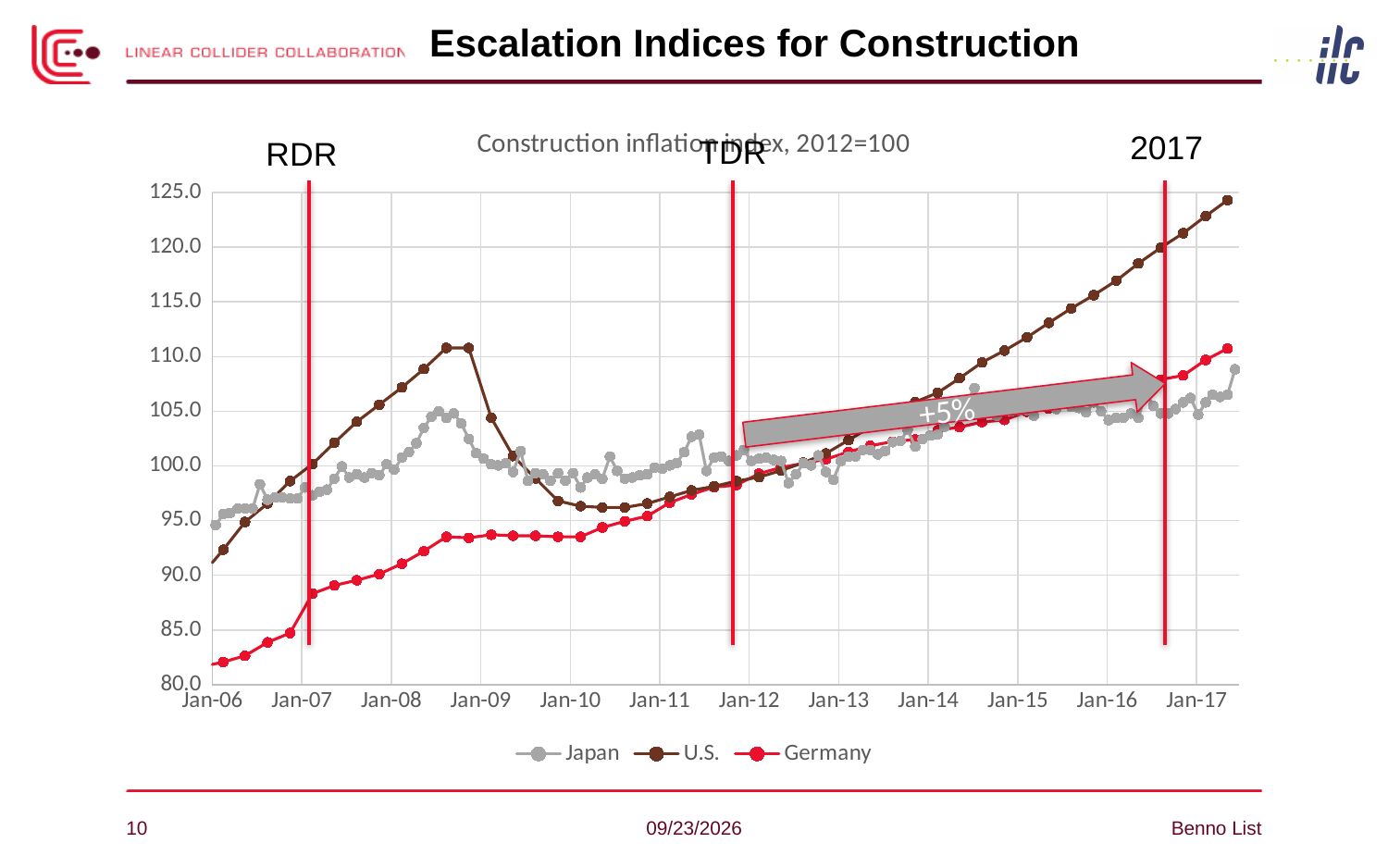
At Jan-10, which series is higher, Japan or U.S.? Japan Which series has the highest value at Jan-17? U.S. What kind of chart is shown on the slide? line chart Is the value for U.S. at Jan-10 greater or less than 100? less Is the value for Germany at Jan-06 greater or less than 85? less What is the title of the chart? Construction inflation index, 2012=100 How many series does the legend list? 3 Does the U.S. series rise or fall between Jan-12 and Jan-17? rise Which series has the lowest value at Jan-06? Germany Is the value for U.S. at Jan-17 greater or less than 120? greater What are the three series named in the legend? Japan, U.S., Germany